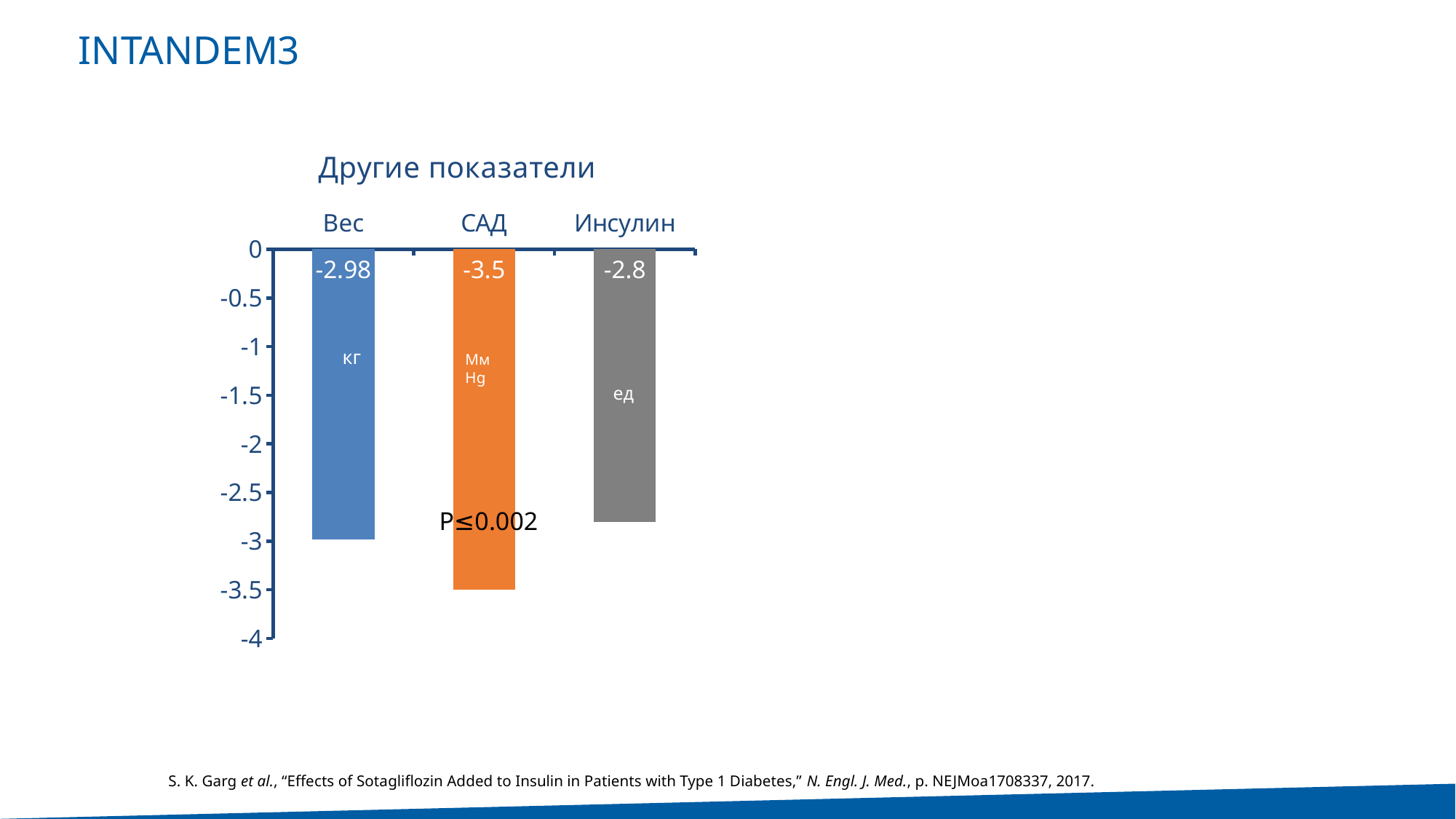
Which value is larger, Вес or Инсулин? Инсулин Is the value for САД greater or less than -3? less What is the difference between the values for САД and Вес? 0.52 How many categories are shown in the chart? 3 What is the difference between the values for Вес and Инсулин? 0.18 What is the value shown for САД in the chart? -3.5 What is the value shown for Инсулин in the chart? -2.8 What kind of chart is shown on the slide? bar chart What is the title of the chart? Другие показатели Which category has the lowest (most negative) value in the chart? САД Which category has the highest (least negative) value in the chart? Инсулин What is the value shown for Вес in the chart? -2.98